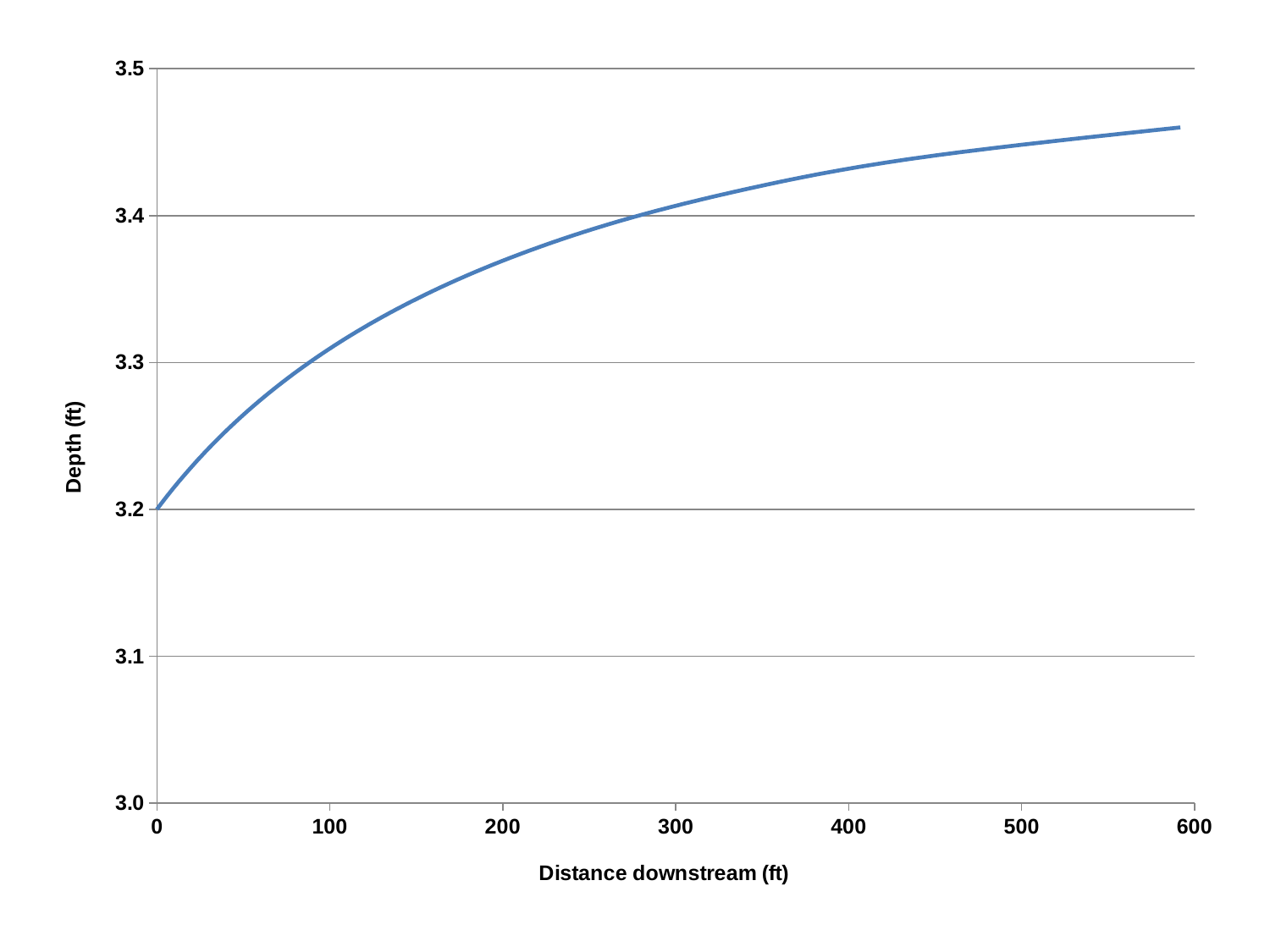
At which end of the distance range is the depth lowest? 0 ft Is the depth at a distance downstream of 200 ft greater or less than 3.4? less Is the depth at a distance downstream of 500 ft greater or less than 3.5? less What is the label of the vertical axis? Depth (ft) Is the depth at a distance downstream of 400 ft greater or less than 3.4? greater What is the depth at a distance downstream of 0 ft? 3.2 What is the label of the horizontal axis? Distance downstream (ft) What kind of chart is shown on the slide? line chart Is the depth greater at 100 ft or at 400 ft downstream? 400 ft Does the depth rise or fall as distance downstream increases? rise